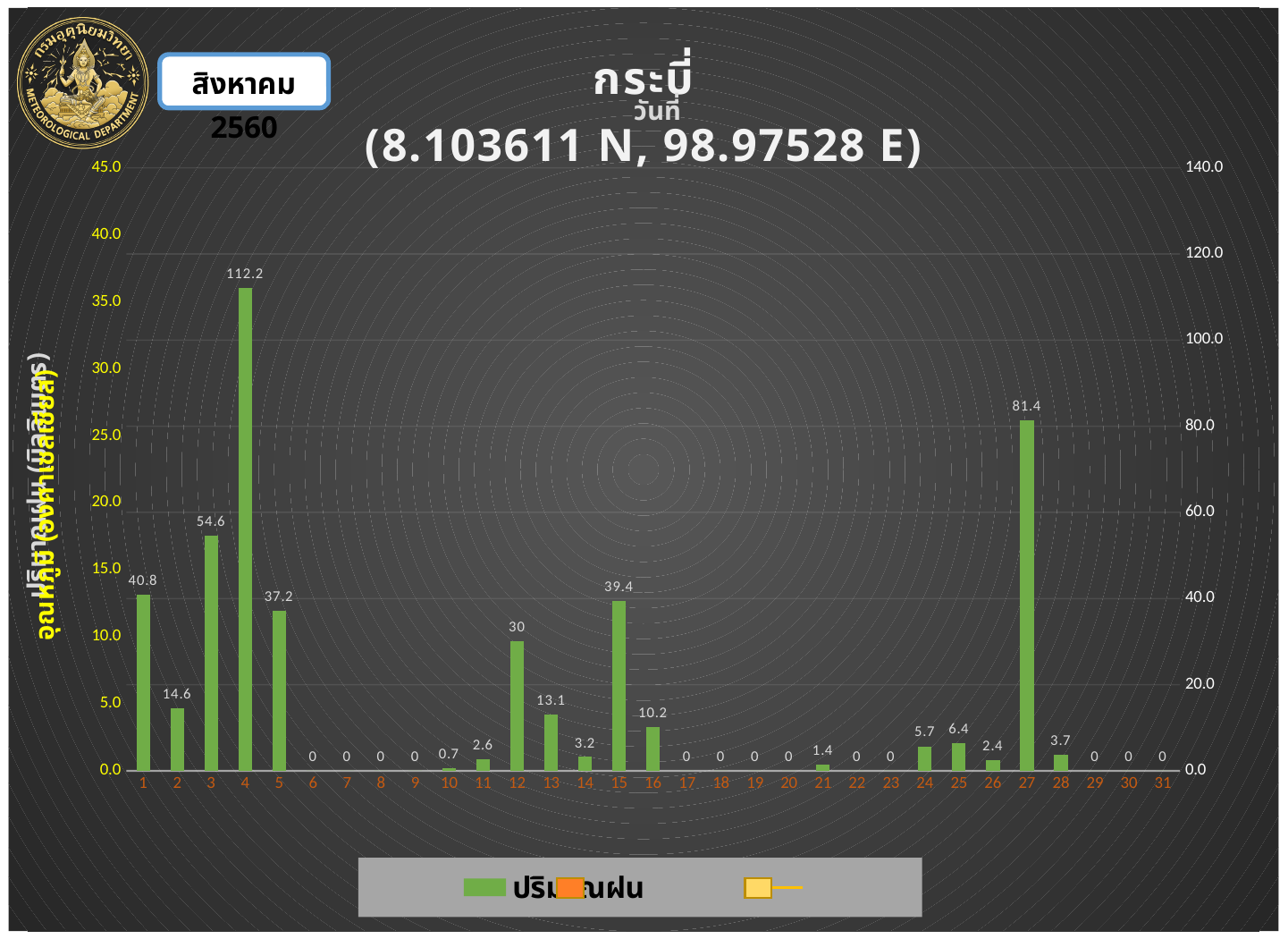
What is the rainfall value for day 12? 30 Which is larger, the rainfall value for day 13 or for day 16? day 13 What is the rainfall value for day 27? 81.4 What is the rainfall value for day 15? 39.4 Which day has the highest rainfall value? 4 What is the difference between the rainfall values for day 4 and day 27? 30.8 How many days (categories) are shown on the x axis? 31 What is the difference between the rainfall values for day 3 and day 1? 13.8 What are the coordinates shown in the chart title? 8.103611 N, 98.97528 E What kind of chart is shown on the slide? bar chart What is the rainfall value for day 4? 112.2 Which is larger, the rainfall value for day 5 or for day 15? day 15